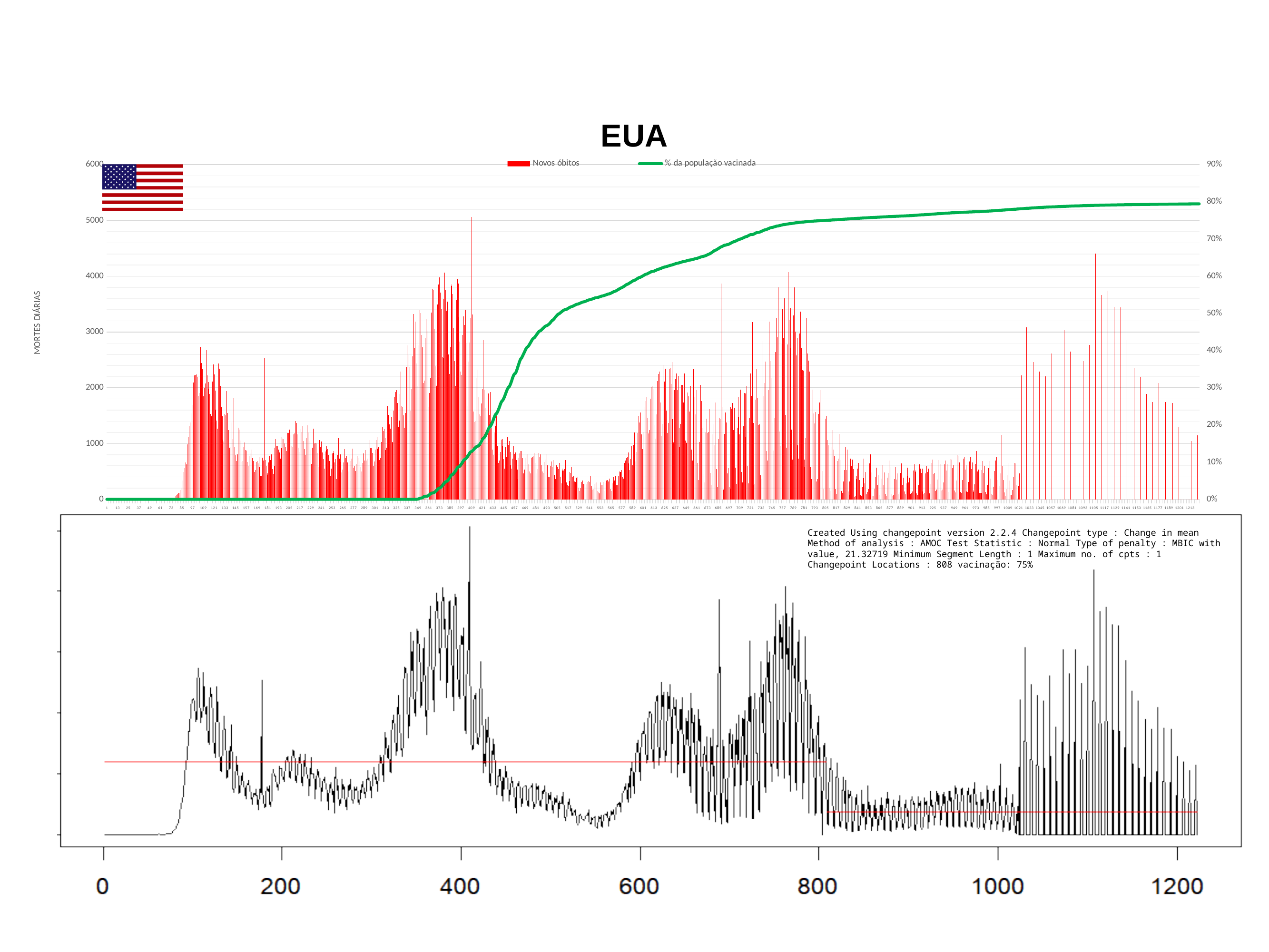
In the top chart, what is the highest value shown on the left vertical axis? 6000 In the top chart, is the tallest red bar (around day 409) greater or less than 4000? greater In the top chart, what is the highest value shown on the right vertical axis? 90% What is the title of the top chart? EUA In the top chart, what kind of chart is used for the 'Novos óbitos' series? Bar chart In the top chart, how many series does the legend list? 2 In the bottom chart, what vaccination percentage is reported at the changepoint? 75% In the top chart, is the green line at the far right end greater or less than 70%? greater In the top chart, what are the two legend entries? Novos óbitos; % da população vacinada In the top chart, does the green '% da população vacinada' line rise or fall along the x axis? Rises In the bottom chart, at what location is the changepoint reported? 808 In the bottom chart, what is the largest tick value shown on the horizontal axis? 1200